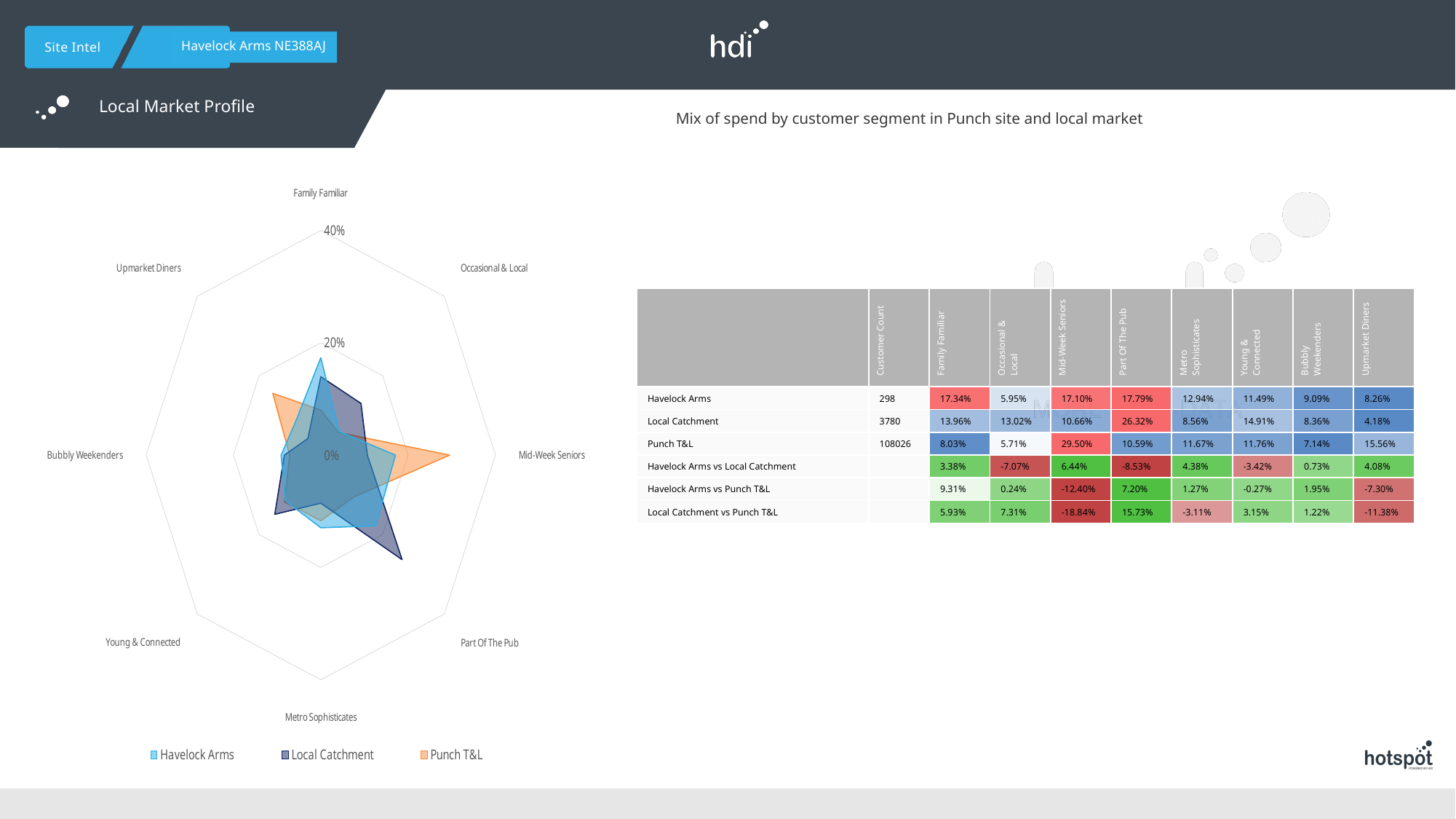
According to the table, what is the Havelock Arms share for Part Of The Pub? 17.79% In the radar chart, is the Local Catchment value for Part Of The Pub greater or less than 20%? greater In the radar chart, is the Havelock Arms value for Family Familiar greater or less than 20%? less According to the table, what is the Customer Count for Local Catchment? 3780 What is the highest percentage tick shown on the radar chart's axis? 40% What kind of chart is shown on the left of the slide? Radar chart How many customer segment categories does the radar chart have? 8 Which series has the highest value for Mid-Week Seniors? Punch T&L What are the three series named in the radar chart's legend? Havelock Arms, Local Catchment, Punch T&L In the radar chart, is the Punch T&L value for Mid-Week Seniors greater or less than 20%? greater According to the table, what is the difference between Havelock Arms and Local Catchment for Family Familiar (Havelock Arms vs Local Catchment)? 3.38% How many series does the radar chart's legend list? 3